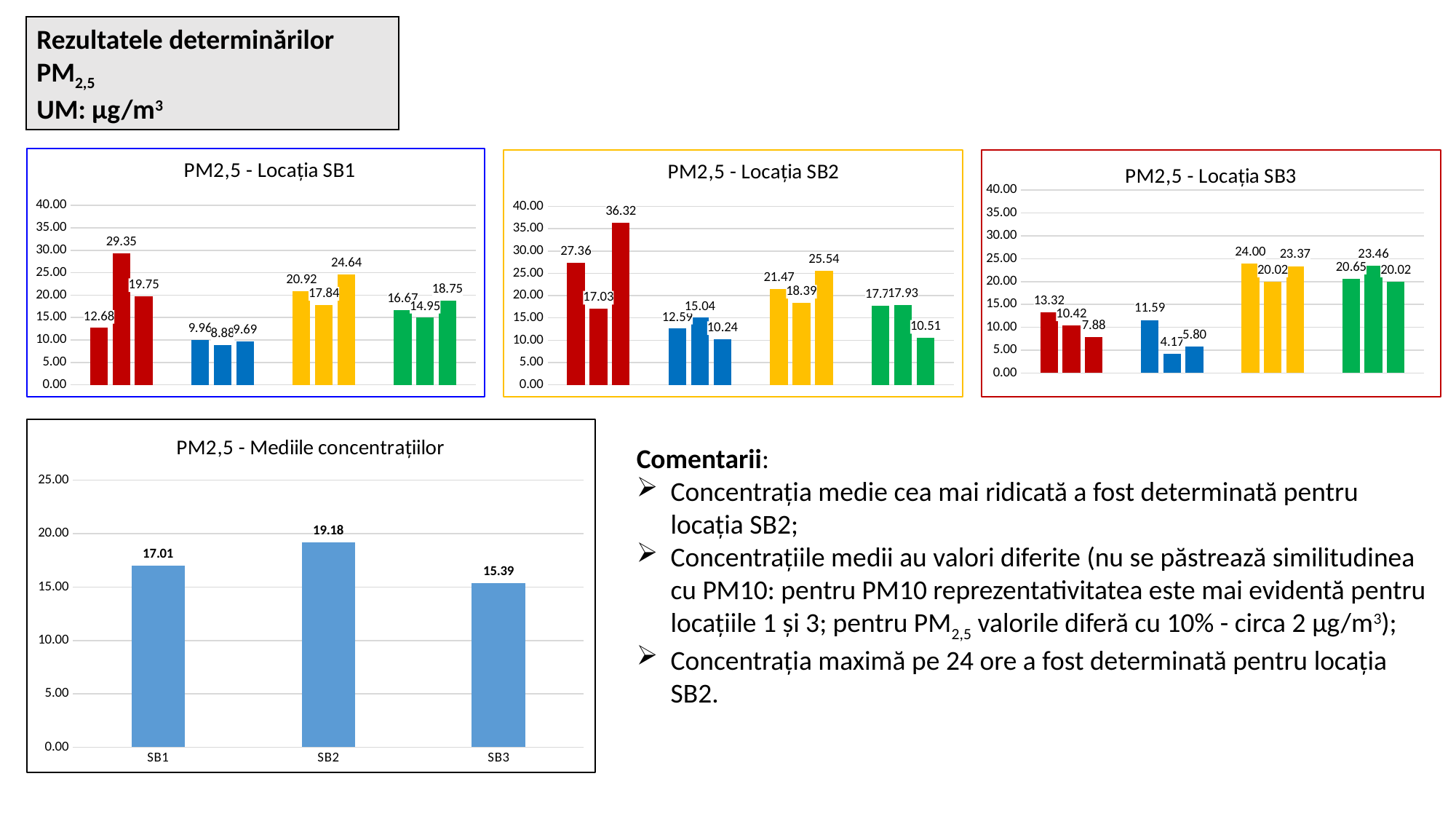
How many charts are shown on the slide? 4 In the chart titled 'PM2,5 - Mediile concentrațiilor', which location has the lowest value? SB3 In the chart titled 'PM2,5 - Mediile concentrațiilor', which location has the highest value? SB2 In the chart titled 'PM2,5 - Mediile concentrațiilor', how many locations are shown on the x axis? 3 What kind of chart is 'PM2,5 - Mediile concentrațiilor'? bar chart In the chart titled 'PM2,5 - Locația SB1', what is the highest value labeled on any bar? 29.35 In the chart titled 'PM2,5 - Locația SB3', what is the lowest value labeled on any bar? 4.17 In the chart titled 'PM2,5 - Mediile concentrațiilor', what is the value for SB2? 19.18 In the chart titled 'PM2,5 - Locația SB2', what is the highest value labeled on any bar? 36.32 In the chart titled 'PM2,5 - Mediile concentrațiilor', what is the difference between the values for SB2 and SB1? 2.17 In the chart titled 'PM2,5 - Mediile concentrațiilor', which is larger, the value for SB1 or the value for SB3? SB1 In the chart titled 'PM2,5 - Mediile concentrațiilor', what is the value for SB3? 15.39